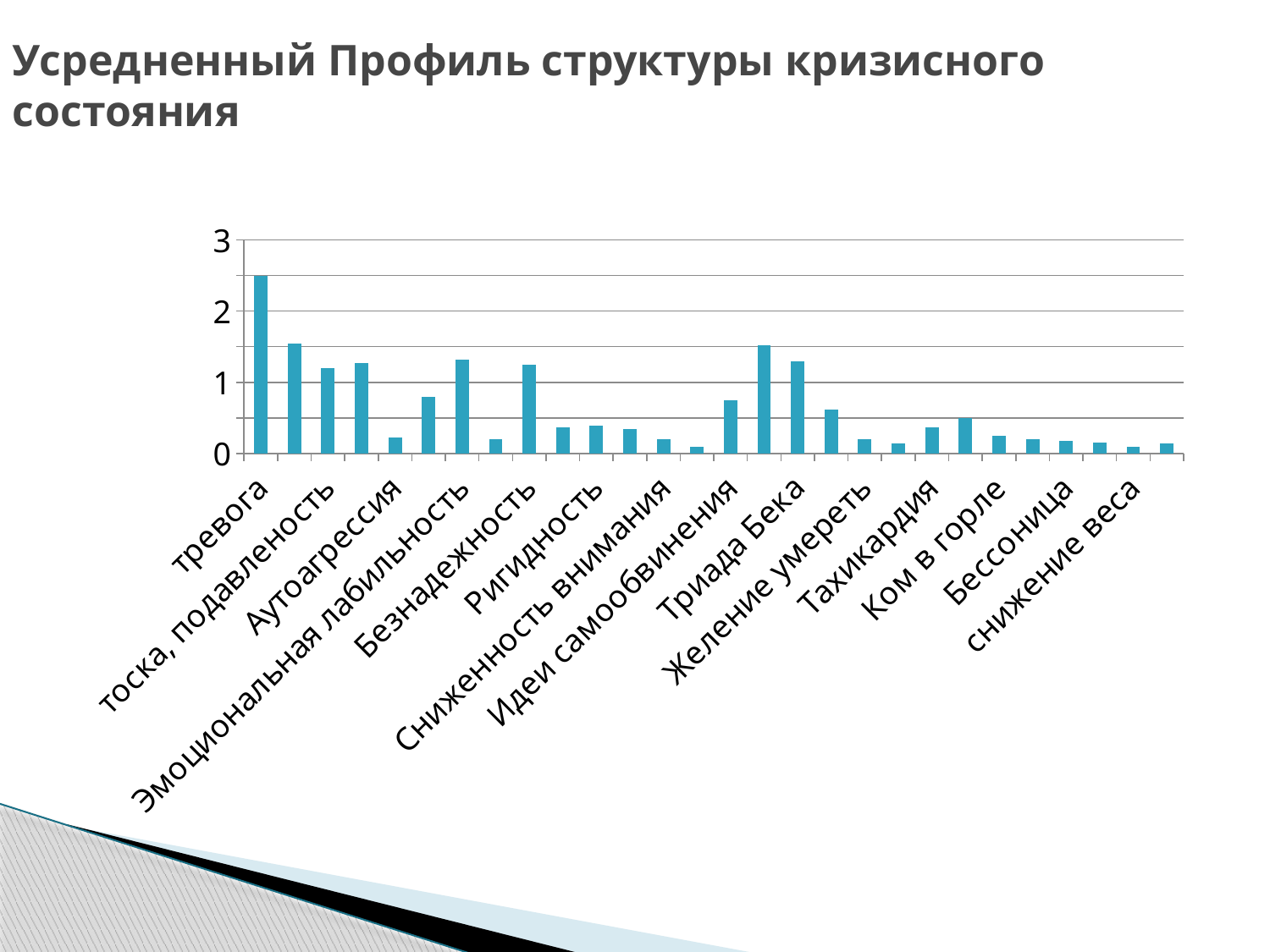
Which category has the highest value in the chart? тревога Is the value for Безнадежность greater or less than 1? greater Which is larger, the value for Аутоагрессия or the value for Эмоциональная лабильность? Эмоциональная лабильность What kind of chart is shown on the slide? bar chart What is the title of the slide containing the chart? Усредненный Профиль структуры кризисного состояния Is the value for Аутоагрессия greater or less than 1? less Is the value for Триада Бека greater or less than 1? greater Which is larger, the value for тревога or the value for Триада Бека? тревога What is the highest value shown on the vertical axis of the chart? 3